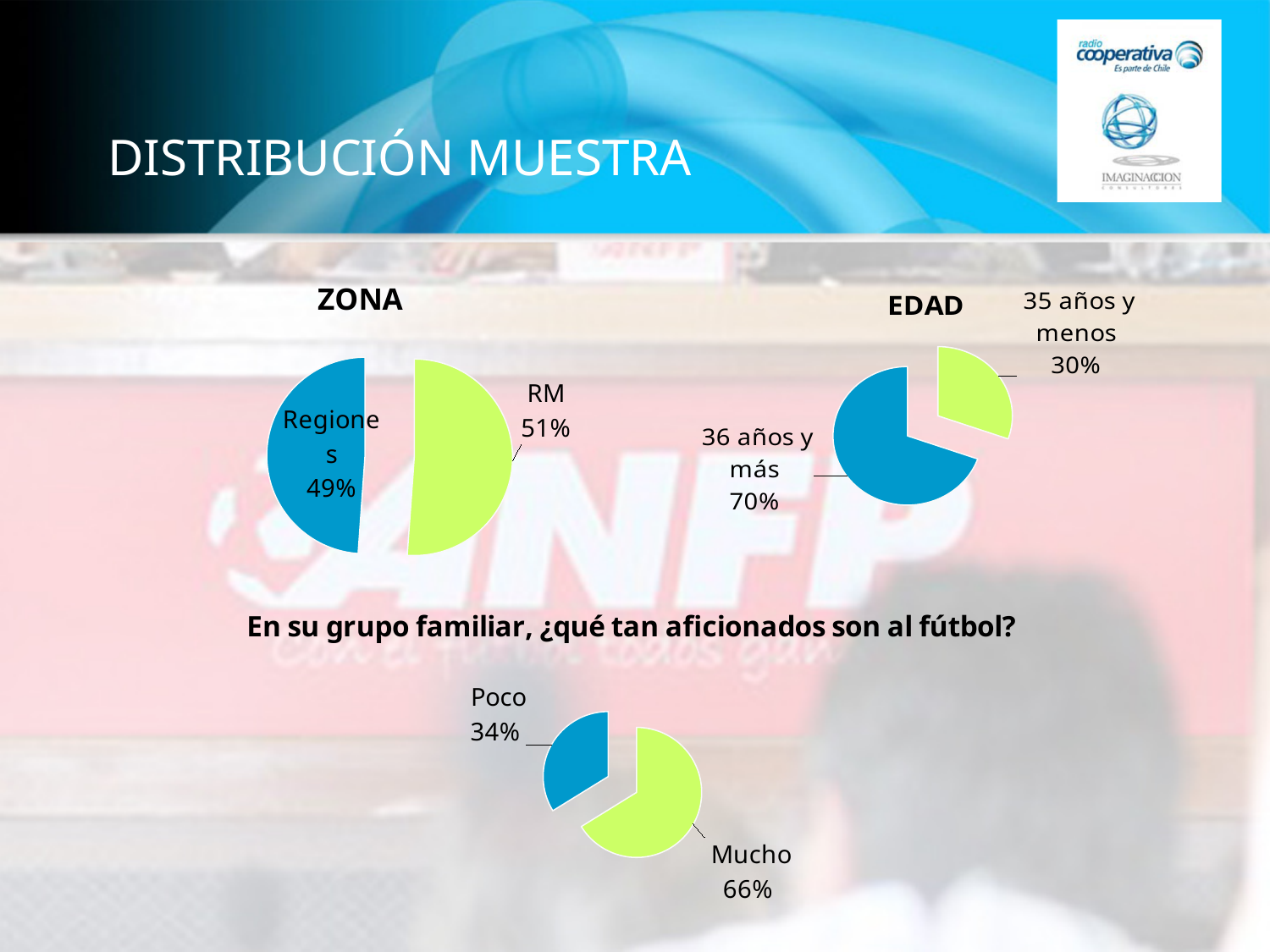
In the pie chart for 'En su grupo familiar, ¿qué tan aficionados son al fútbol?', what is the difference in percentage points between Mucho and Poco? 32 In the EDAD pie chart, what is the difference in percentage points between '36 años y más' and '35 años y menos'? 40 In the EDAD pie chart, what percentage is shown for '36 años y más'? 70% How many slices does the ZONA pie chart have? 2 In the ZONA pie chart, what percentage is shown for Regiones? 49% In the pie chart for 'En su grupo familiar, ¿qué tan aficionados son al fútbol?', what percentage answered Mucho? 66% In the ZONA pie chart, what percentage is shown for RM? 51% In the EDAD pie chart, which category has the largest share? 36 años y más In the pie chart for 'En su grupo familiar, ¿qué tan aficionados son al fútbol?', which category has the smallest share? Poco In the pie chart for 'En su grupo familiar, ¿qué tan aficionados son al fútbol?', what percentage answered Poco? 34% What type of chart is the EDAD chart? Pie chart In the EDAD pie chart, what percentage is shown for '35 años y menos'? 30%